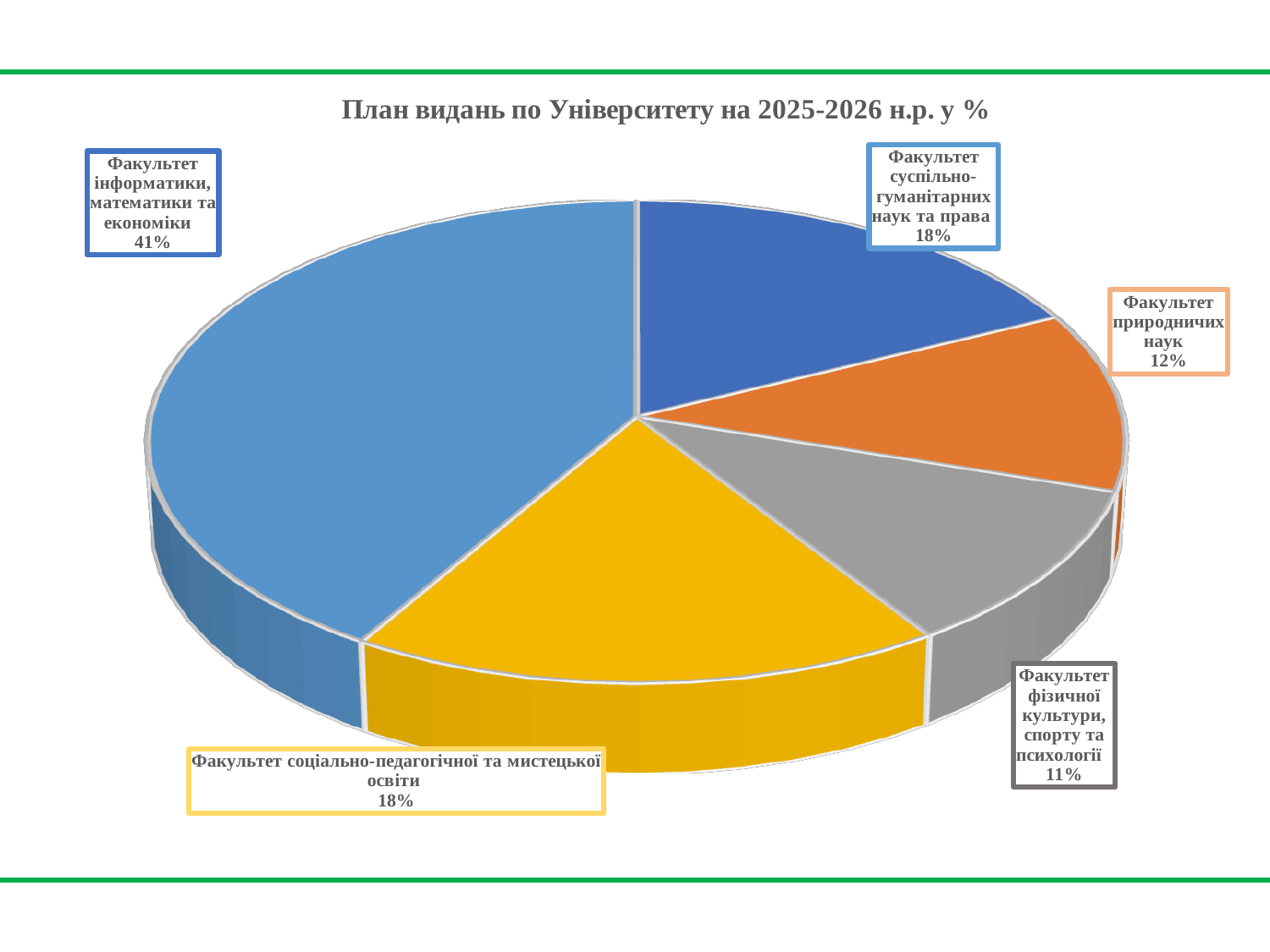
How many slices does the pie chart have? 5 Which is larger: the share of Факультет природничих наук or the share of Факультет суспільно-гуманітарних наук та права? Факультет суспільно-гуманітарних наук та права What is the value for Факультет фізичної культури, спорту та психології? 11% What is the value for Факультет природничих наук? 12% What is the value for Факультет суспільно-гуманітарних наук та права? 18% Which faculty has the largest share of the pie? Факультет інформатики, математики та економіки What is the title of the chart? План видань по Університету на 2025-2026 н.р. у % Which faculty has the smallest share of the pie? Факультет фізичної культури, спорту та психології What colour is the slice for Факультет соціально-педагогічної та мистецької освіти? Yellow What is the difference between the shares of Факультет інформатики, математики та економіки and Факультет соціально-педагогічної та мистецької освіти? 23% What share of the pie is Факультет інформатики, математики та економіки? 41% What kind of chart is shown on the slide? Pie chart